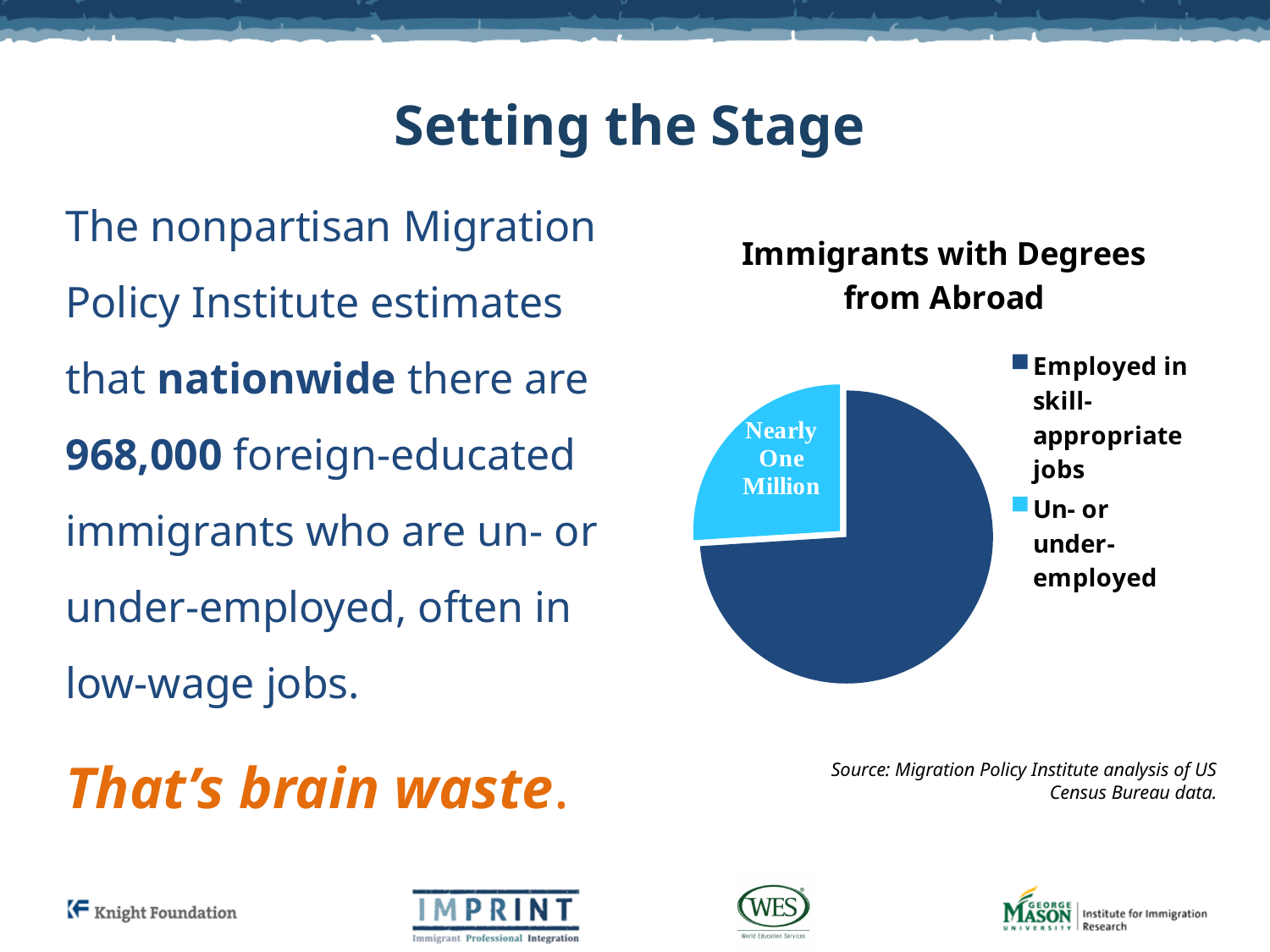
What is the title of the pie chart? Immigrants with Degrees from Abroad Which slice of the pie chart is the smallest? Un- or under-employed How many slices does the pie chart have? 2 Which slice is larger: "Employed in skill-appropriate jobs" or "Un- or under-employed"? Employed in skill-appropriate jobs What kind of chart is shown on the slide? Pie chart Which slice of the pie chart is the largest? Employed in skill-appropriate jobs How many entries does the legend of the pie chart list? 2 Is the share of the "Employed in skill-appropriate jobs" slice greater or less than 50% of the pie? greater Is the share of the "Un- or under-employed" slice greater or less than 50% of the pie? less What text label is printed on the "Un- or under-employed" slice of the pie chart? Nearly One Million